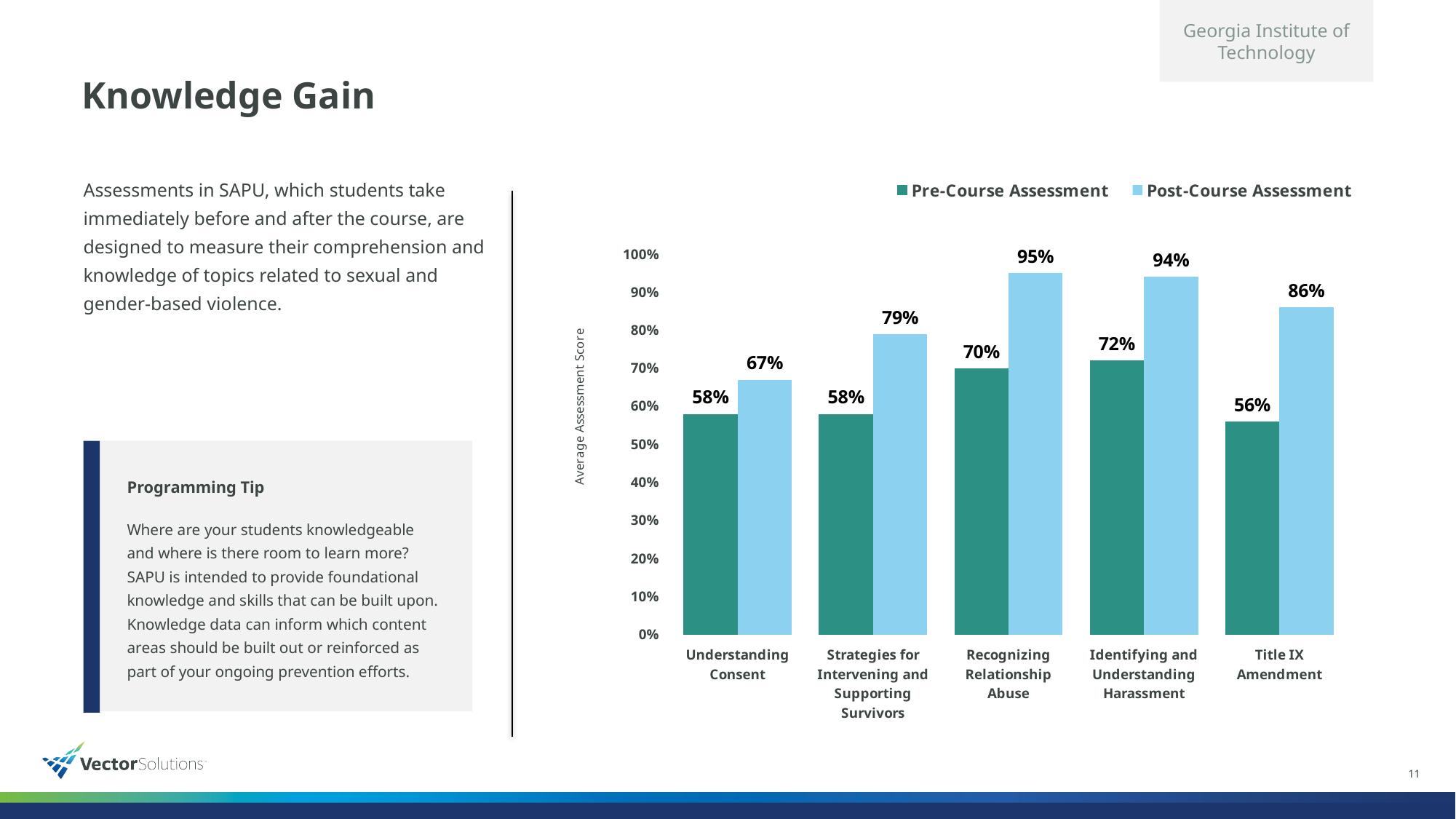
What is the label of the vertical axis? Average Assessment Score What is the Pre-Course Assessment value for Title IX Amendment? 56% What is the Pre-Course Assessment value for Identifying and Understanding Harassment? 72% How many categories are shown on the x axis? 5 How many series does the legend list? 2 What kind of chart is shown on the slide? Bar chart What is the difference between the Post-Course and Pre-Course Assessment values for Understanding Consent? 9% What is the Post-Course Assessment value for Recognizing Relationship Abuse? 95% Which is larger: the Post-Course Assessment value for Strategies for Intervening and Supporting Survivors or the Post-Course Assessment value for Title IX Amendment? Title IX Amendment What is the difference between the Post-Course and Pre-Course Assessment values for Title IX Amendment? 30% Which category has the highest Post-Course Assessment value? Recognizing Relationship Abuse Which category has the lowest Pre-Course Assessment value? Title IX Amendment